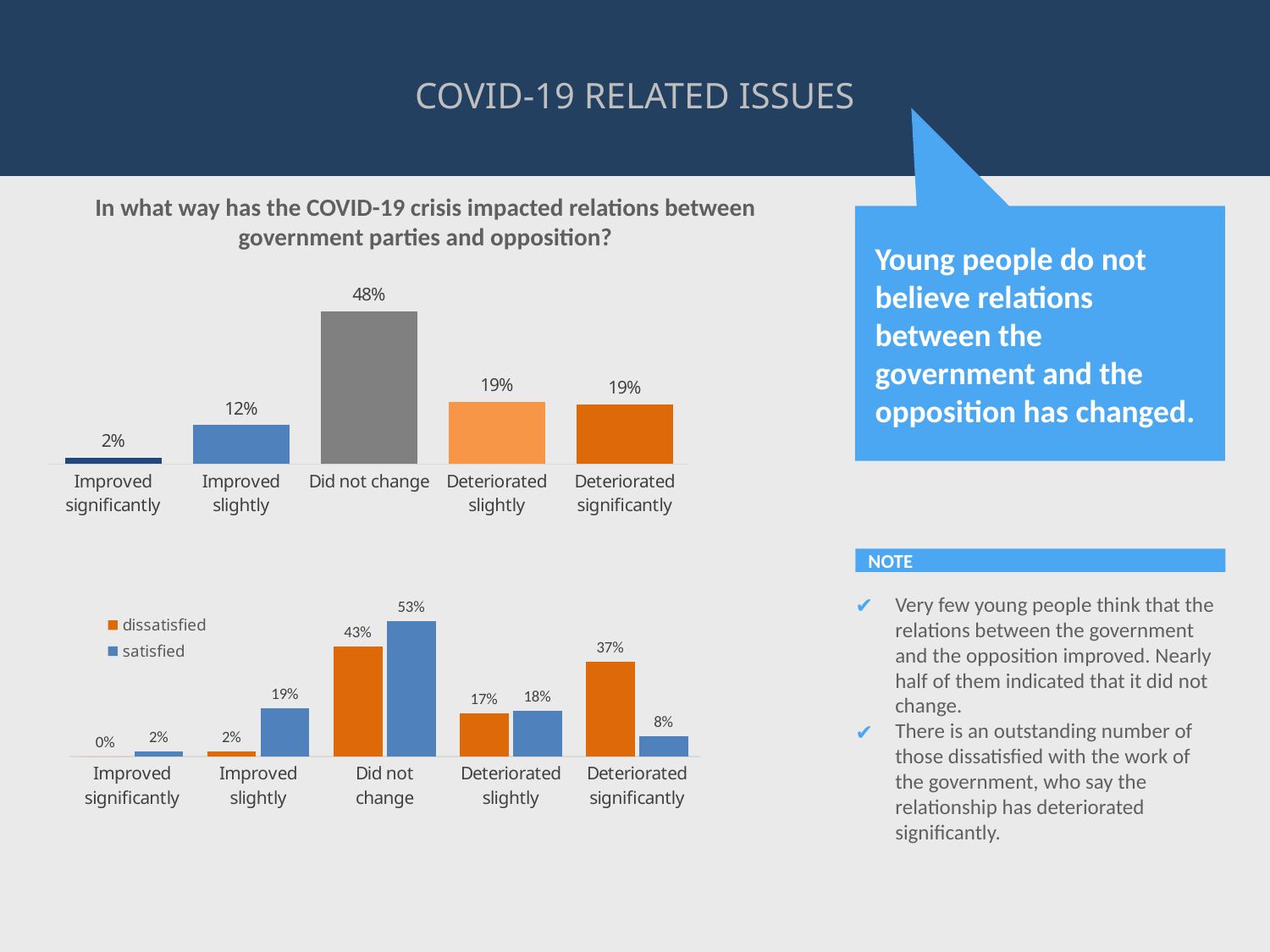
In the top chart, how many categories are shown? 5 What type of chart is the top chart? Bar chart In the top chart, what is the difference between 'Did not change' and 'Improved slightly'? 36% In the bottom chart, what colour represents the 'dissatisfied' series? Orange In the top chart, what percentage said relations 'Did not change'? 48% In the bottom chart, what is the difference between dissatisfied and satisfied for 'Deteriorated significantly'? 29% In the bottom chart, what is the value for 'dissatisfied' in the 'Deteriorated significantly' category? 37% In the bottom chart, what is the value for 'satisfied' in the 'Did not change' category? 53% In the bottom chart, which series has the larger value for 'Deteriorated significantly', dissatisfied or satisfied? dissatisfied In the bottom chart, how many series does the legend list? 2 In the top chart, which category has the lowest value? Improved significantly In the bottom chart, which category has the highest value for the 'satisfied' series? Did not change